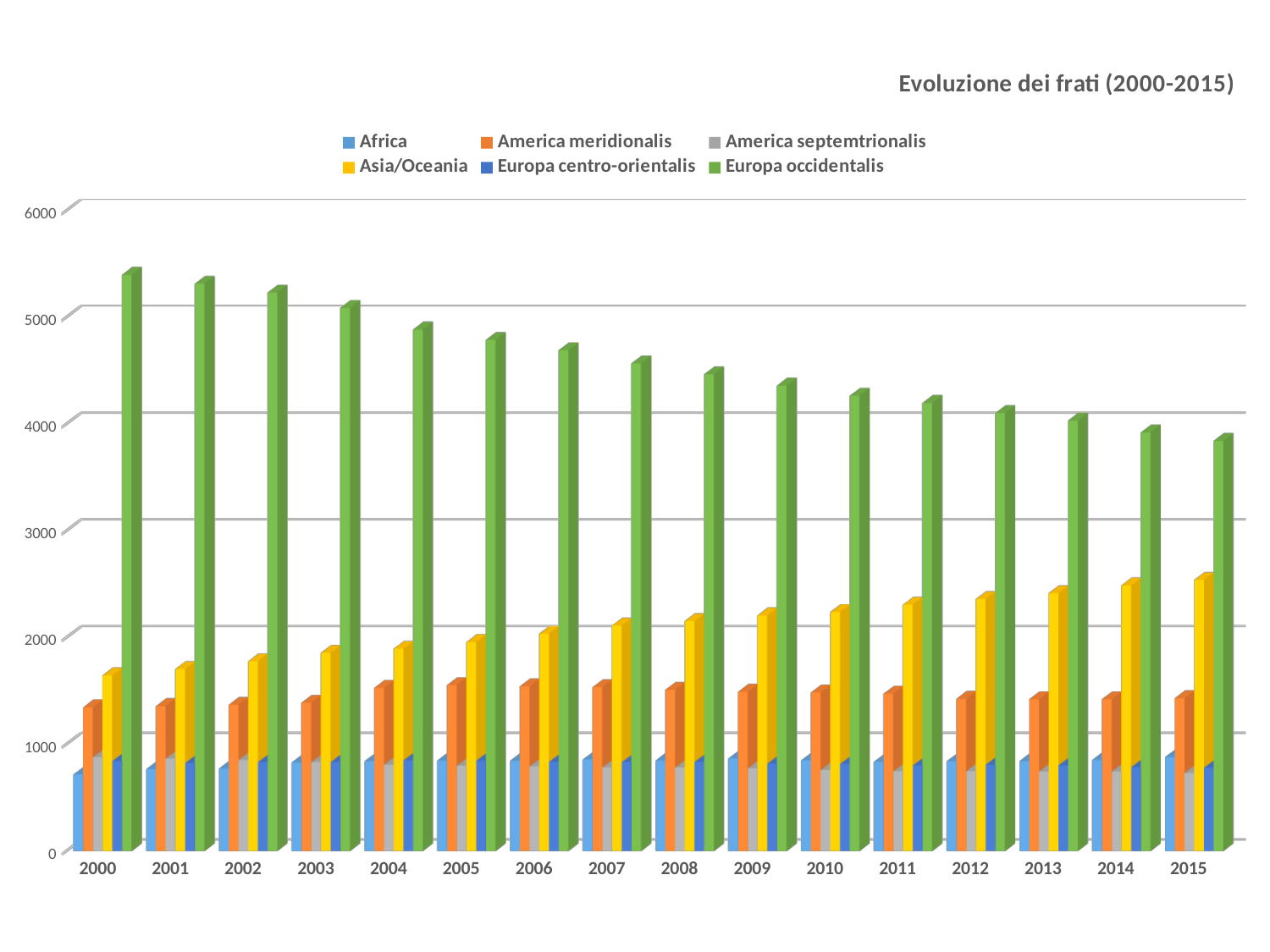
What kind of chart is shown on the slide? bar chart Is the value for Europa occidentalis in 2015 greater or less than 4000? less Do the values for Europa occidentalis rise or fall from 2000 to 2015? fall How many years are shown along the x axis? 16 Is the value for Asia/Oceania in 2015 greater or less than 2000? greater In 2015, which is larger: Asia/Oceania or America meridionalis? Asia/Oceania Do the values for Asia/Oceania rise or fall from 2000 to 2015? rise Is the value for Europa occidentalis in 2000 greater or less than 5000? greater What is the title of the chart? Evoluzione dei frati (2000-2015) How many series does the legend list? 6 Which series has the highest value in 2000? Europa occidentalis